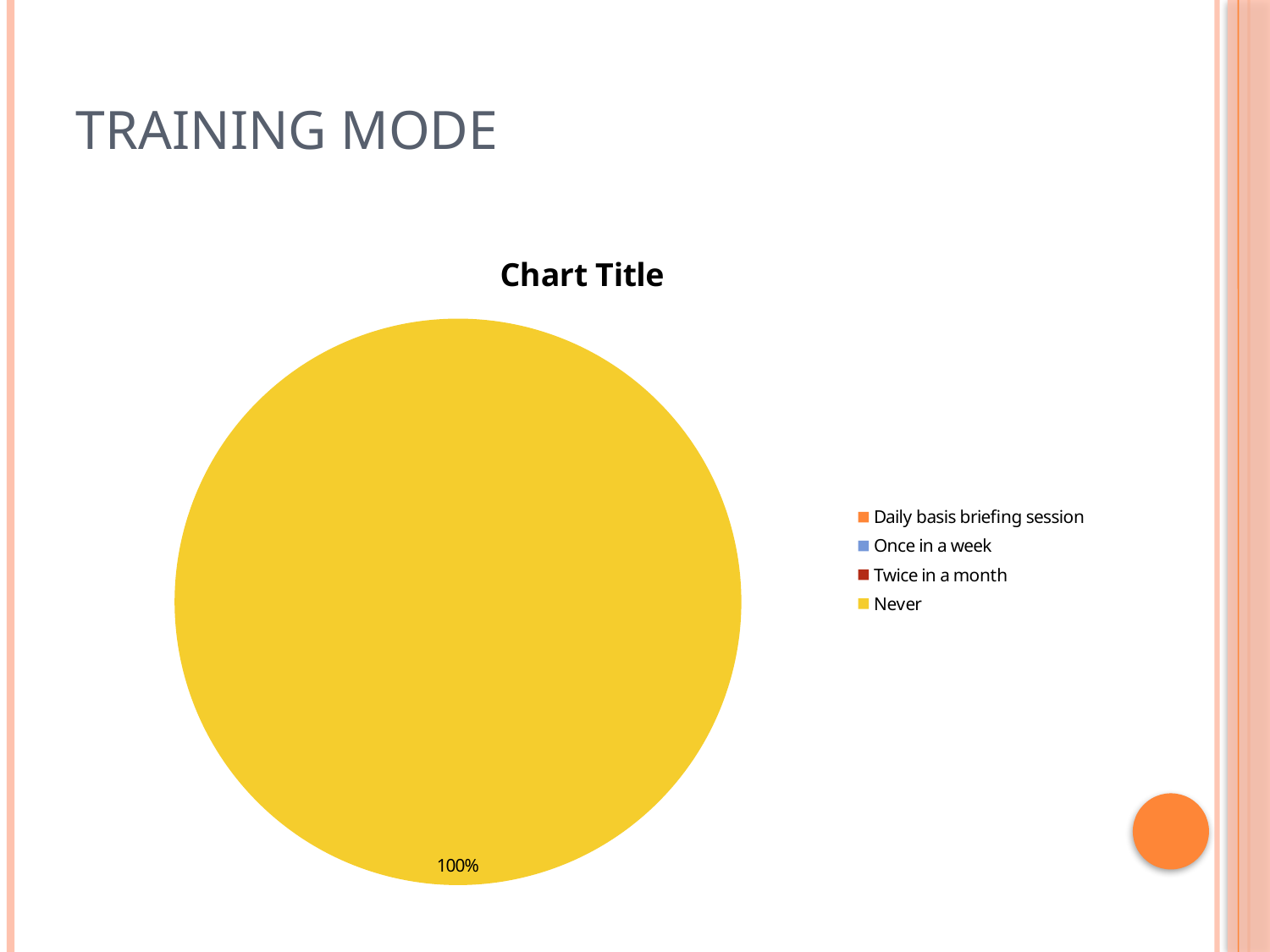
How many slices are visible in the pie chart? 1 Which category has the largest share of the pie? Never What kind of chart is shown on the slide? pie chart Which category fills the entire pie? Never What percentage value is printed as a data label on the pie? 100% What share of the pie does the Never slice take? 100% What colour is the Never slice in the pie chart? yellow How many categories does the legend list? 4 What is the title of the chart? Chart Title